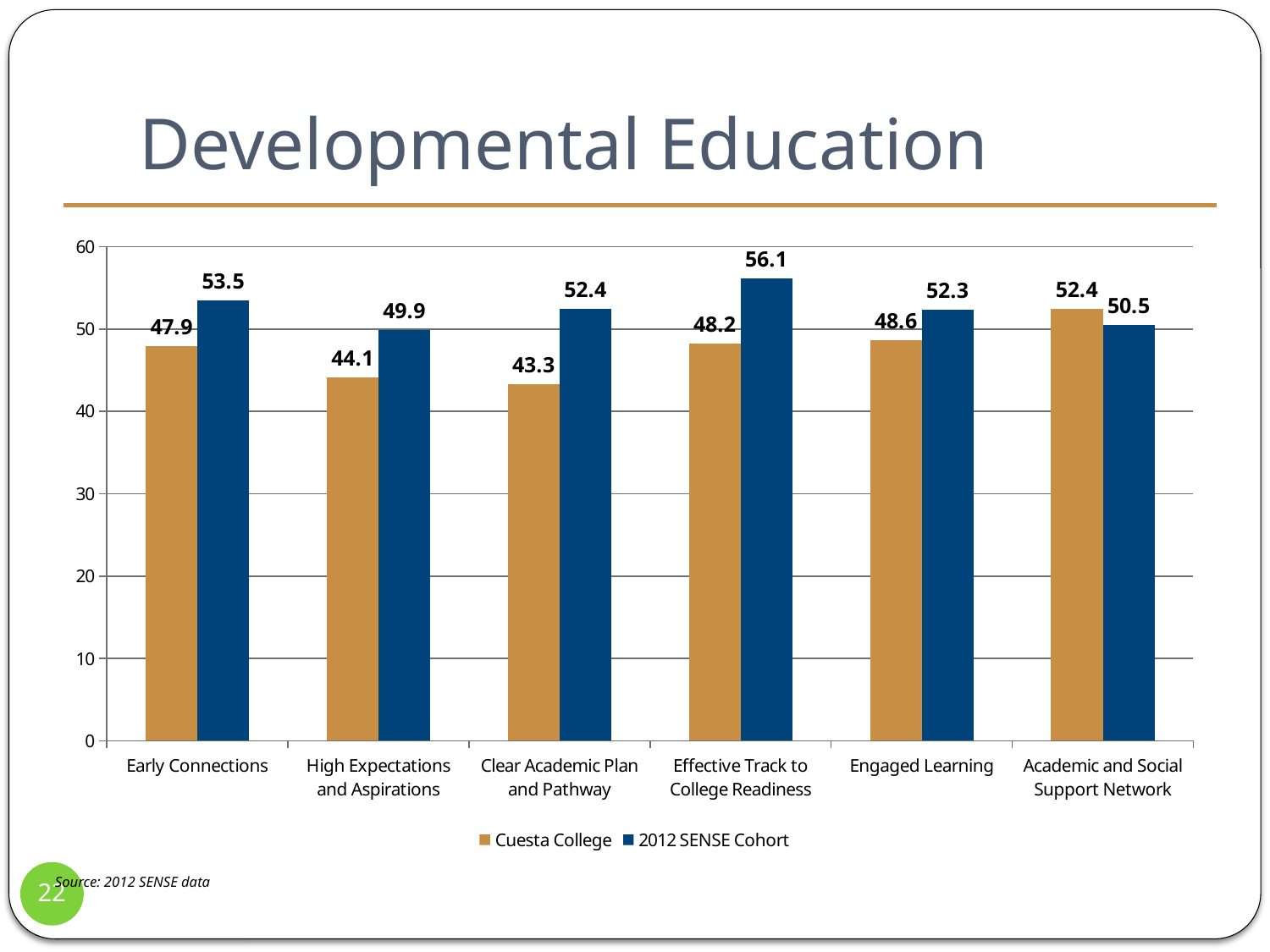
How many categories are shown on the x axis? 6 What is the difference between the 2012 SENSE Cohort and Cuesta College values for Clear Academic Plan and Pathway? 9.1 What is the 2012 SENSE Cohort value for Effective Track to College Readiness? 56.1 What is the Cuesta College value for Clear Academic Plan and Pathway? 43.3 What is the Cuesta College value for Early Connections? 47.9 What is the title of the slide containing the chart? Developmental Education What kind of chart is shown on the slide? bar chart Which category has the lowest Cuesta College value? Clear Academic Plan and Pathway Which category has the highest 2012 SENSE Cohort value? Effective Track to College Readiness Is the Cuesta College value for High Expectations and Aspirations greater or less than 50? less For Academic and Social Support Network, which is larger: Cuesta College or 2012 SENSE Cohort? Cuesta College How many series does the legend list? 2